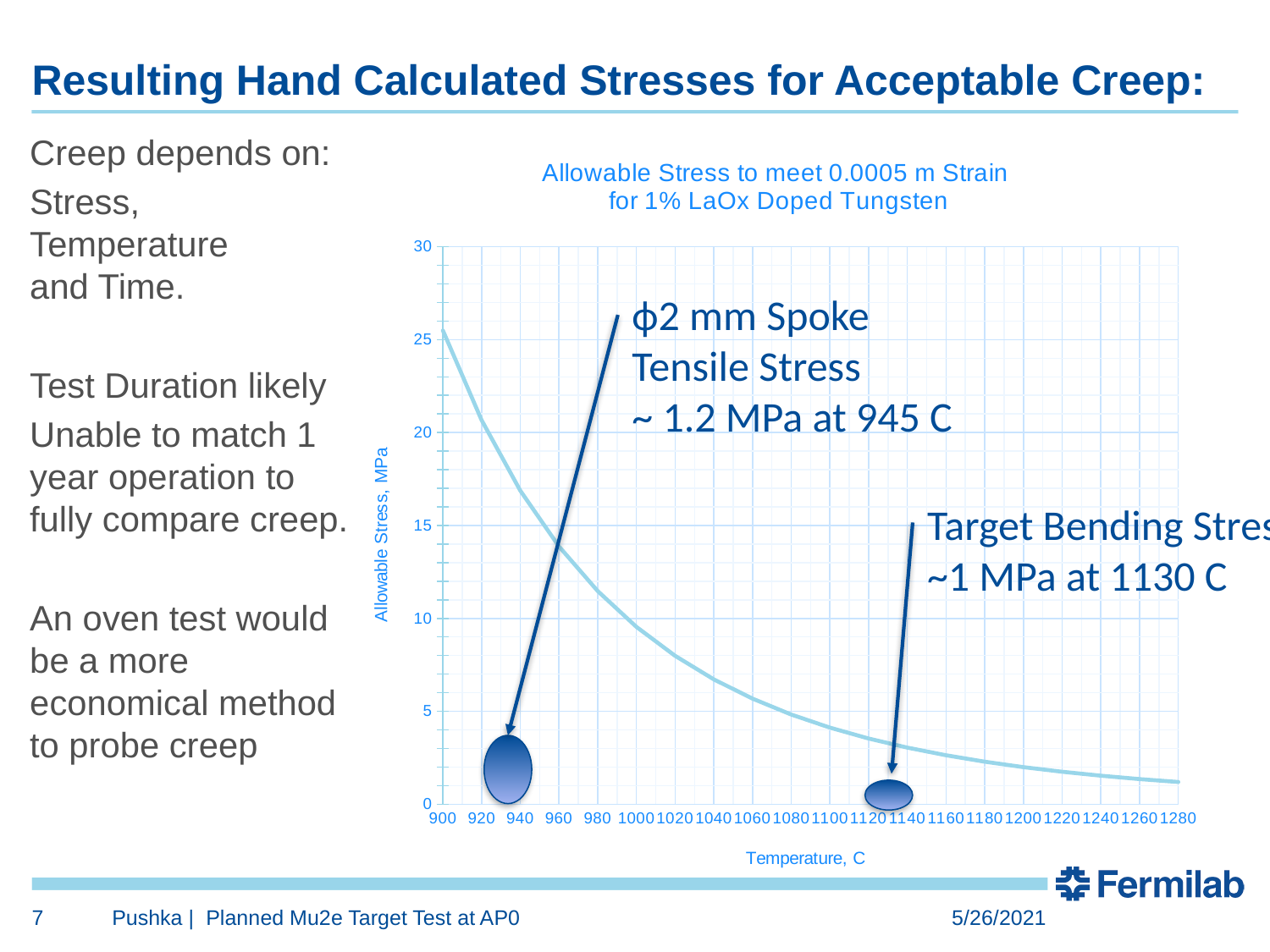
Is the allowable stress at 1280 C greater or less than 5? less What kind of chart is shown on the slide? line chart Is the allowable stress at 1100 C greater or less than 5? less At which temperature shown on the x axis is the allowable stress highest? 900 Which temperature has the higher allowable stress, 900 C or 1280 C? 900 C What is the label of the vertical axis of the chart? Allowable Stress, MPa Is the allowable stress at 960 C greater or less than 10? greater Does the allowable stress rise or fall as temperature increases along the x axis? fall At which temperature shown on the x axis is the allowable stress lowest? 1280 What is the title of the chart? Allowable Stress to meet 0.0005 m Strain for 1% LaOx Doped Tungsten